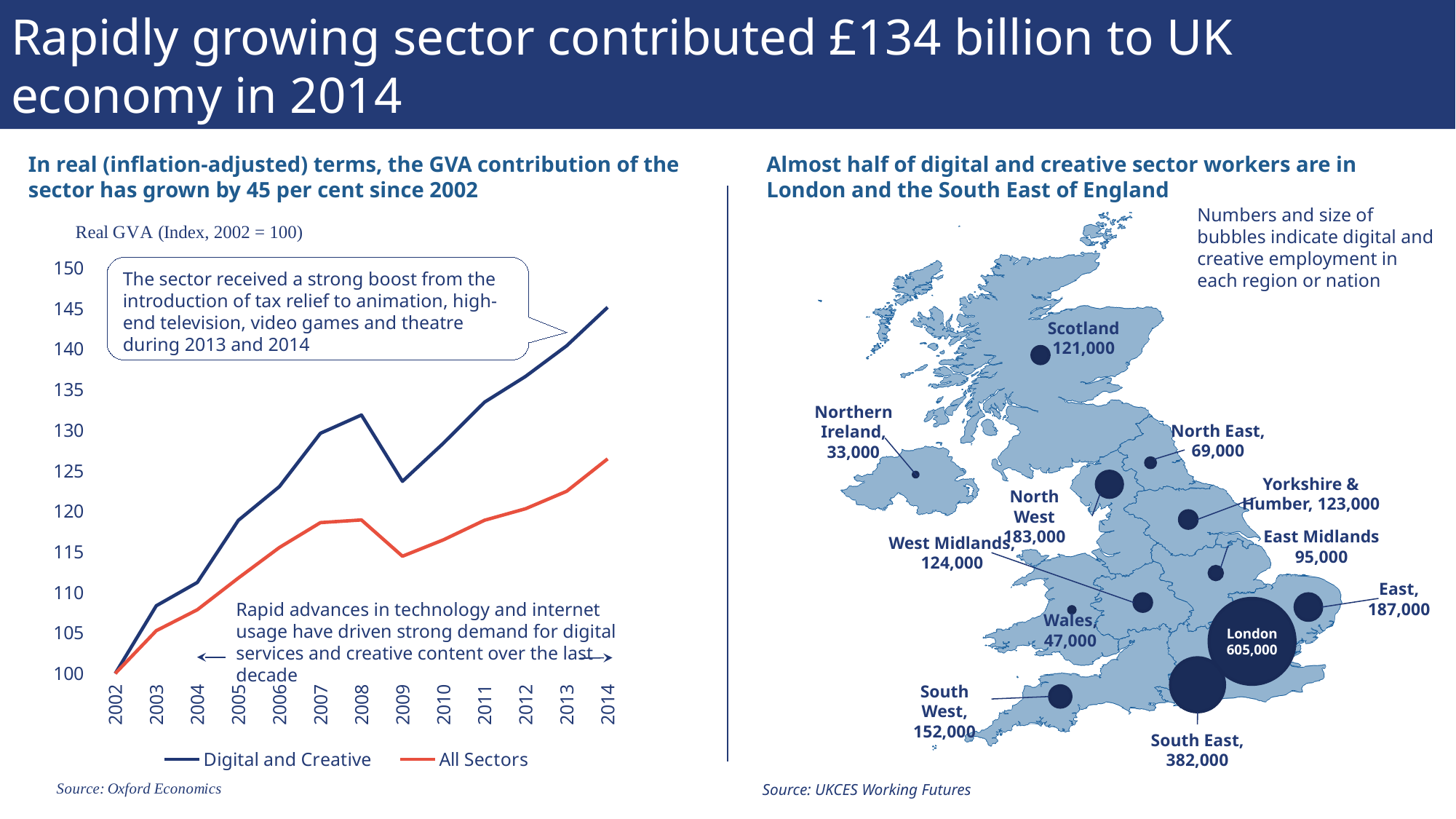
On the UK map chart, which region or nation has the lowest digital and creative employment? Northern Ireland On the UK map chart, which has the larger employment figure, East or North West? East How many series does the legend of the Real GVA line chart list? 2 In the Real GVA line chart, which series has the higher value in 2014, Digital and Creative or All Sectors? Digital and Creative What kind of chart is the Real GVA chart on the left of the slide? line chart How many regions or nations are labelled with employment figures on the UK map chart? 12 How many years are shown on the x axis of the Real GVA line chart? 13 On the UK map chart, what is the difference between the employment figures for the South East and Scotland? 261,000 In the Real GVA line chart, is the Digital and Creative value for 2014 greater or less than 140? greater In the Real GVA line chart, is the All Sectors value for 2014 greater or less than 125? greater On the UK map chart, what is the digital and creative employment figure for London? 605,000 In the Real GVA line chart, does the Digital and Creative series rise or fall overall from 2002 to 2014? rise